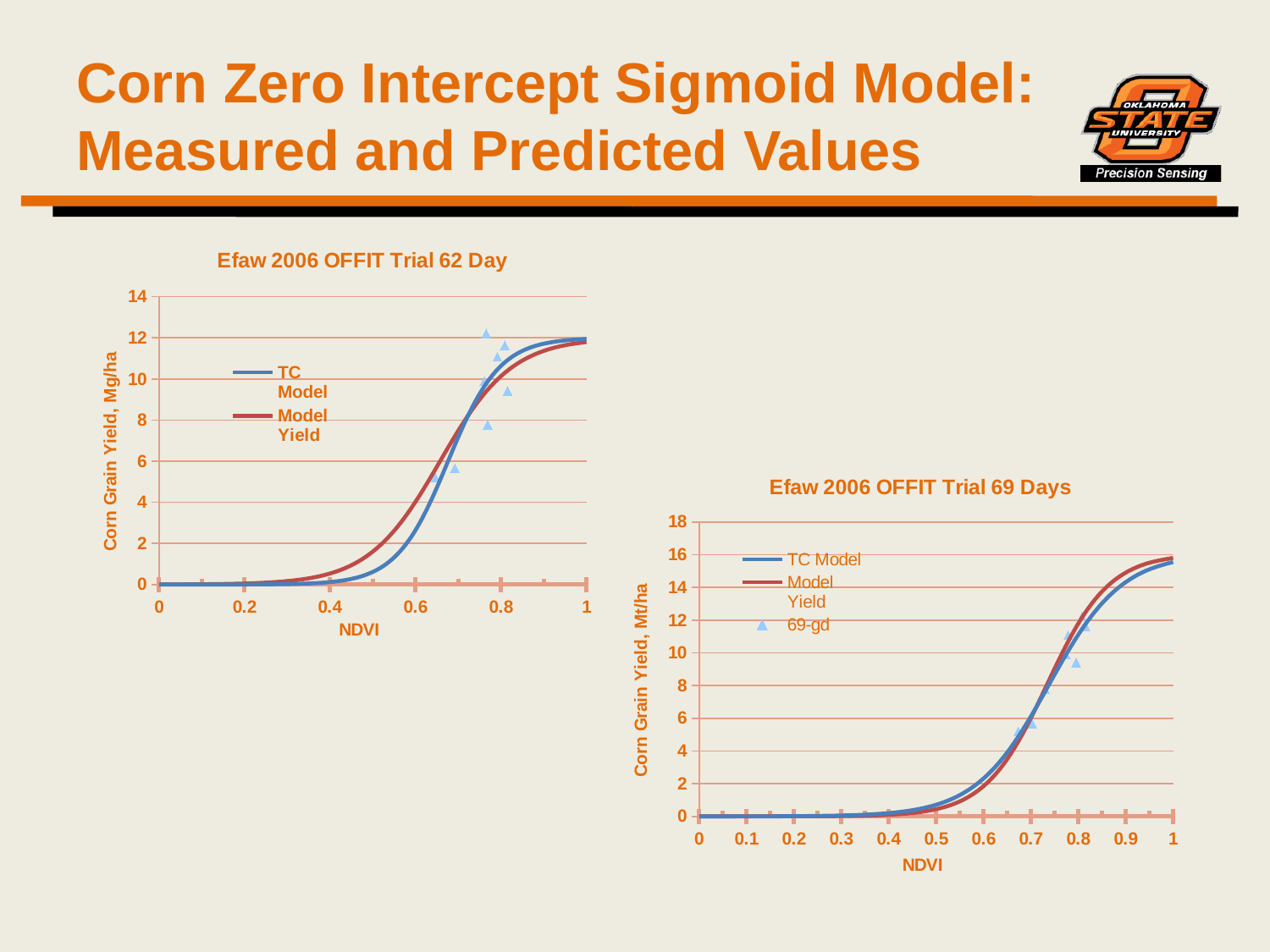
What is the y-axis label of the 'Efaw 2006 OFFIT Trial 62 Day' chart? Corn Grain Yield, Mg/ha What is the x-axis label of the 'Efaw 2006 OFFIT Trial 69 Days' chart? NDVI In the 'Efaw 2006 OFFIT Trial 69 Days' chart, is the TC Model value at NDVI 1 greater or less than 12? greater In the 'Efaw 2006 OFFIT Trial 62 Day' chart, do the model curves rise or fall as NDVI increases? rise How many series does the legend of the 'Efaw 2006 OFFIT Trial 69 Days' chart list? 3 How many series does the legend of the 'Efaw 2006 OFFIT Trial 62 Day' chart list? 2 In the 'Efaw 2006 OFFIT Trial 62 Day' chart, is the Model Yield value at NDVI 0.4 greater or less than 2? less In the 'Efaw 2006 OFFIT Trial 69 Days' chart, do the model curves rise or fall as NDVI increases? rise What type of chart is the 'Efaw 2006 OFFIT Trial 62 Day' chart? line chart In the 'Efaw 2006 OFFIT Trial 69 Days' chart, is the Model Yield value at NDVI 0.5 greater or less than 2? less